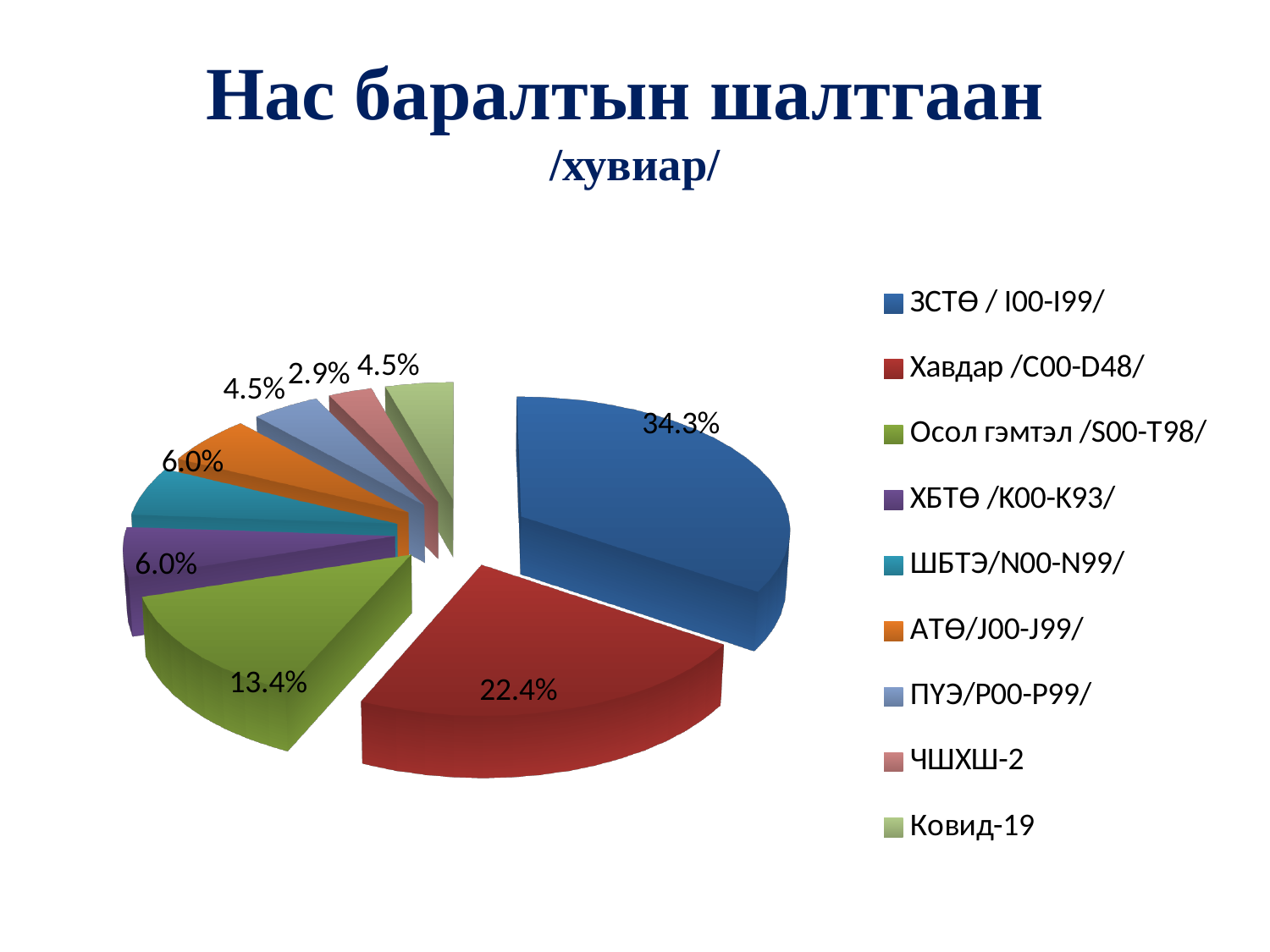
Which category has the largest slice of the pie? ЗСТӨ / I00-I99/ What is the difference between the shares of ЗСТӨ / I00-I99/ and Хавдар /C00-D48/? 11.9 percentage points What share of the pie does ЗСТӨ / I00-I99/ account for? 34.3% What is the value shown for Хавдар /C00-D48/? 22.4% What kind of chart is shown on the slide? pie chart What is the value shown for Осол гэмтэл /S00-T98/? 13.4% How many categories does the legend of the pie chart list? 9 What is the difference between the shares of Хавдар /C00-D48/ and Осол гэмтэл /S00-T98/? 9.0 percentage points What is the value shown for ХБТӨ /K00-K93/? 6.0% Which is larger, the share for Хавдар /C00-D48/ or the share for Осол гэмтэл /S00-T98/? Хавдар /C00-D48/ What colour is the slice for ЗСТӨ / I00-I99/? blue What is the title of the chart on the slide? Нас баралтын шалтгаан /хувиар/